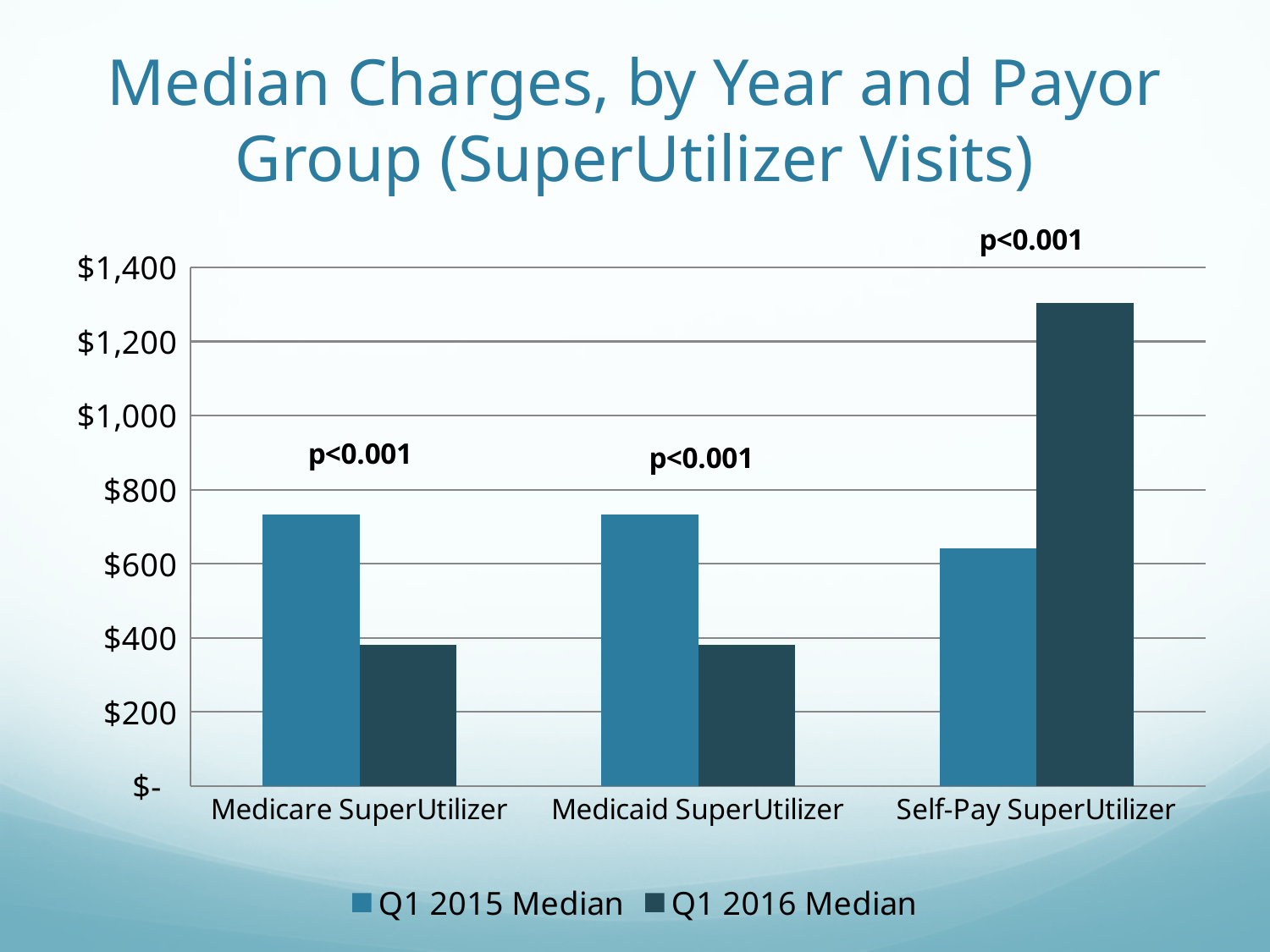
What kind of chart is shown on the slide? Bar chart Is the Q1 2016 Median for Self-Pay SuperUtilizer greater or less than $1,200? greater Which payor group has the highest Q1 2016 Median charge? Self-Pay SuperUtilizer For Self-Pay SuperUtilizer, which is larger: the Q1 2015 Median or the Q1 2016 Median? Q1 2016 Median How many series does the legend list? 2 How many payor group categories are shown on the x axis? 3 What p-value annotation is shown above each payor group? p<0.001 Which payor group has the lowest Q1 2015 Median charge? Self-Pay SuperUtilizer What is the title of the chart? Median Charges, by Year and Payor Group (SuperUtilizer Visits) For Medicare SuperUtilizer, which is larger: the Q1 2015 Median or the Q1 2016 Median? Q1 2015 Median Is the Q1 2015 Median for Medicare SuperUtilizer greater or less than $600? greater Is the Q1 2016 Median for Medicaid SuperUtilizer greater or less than $400? less